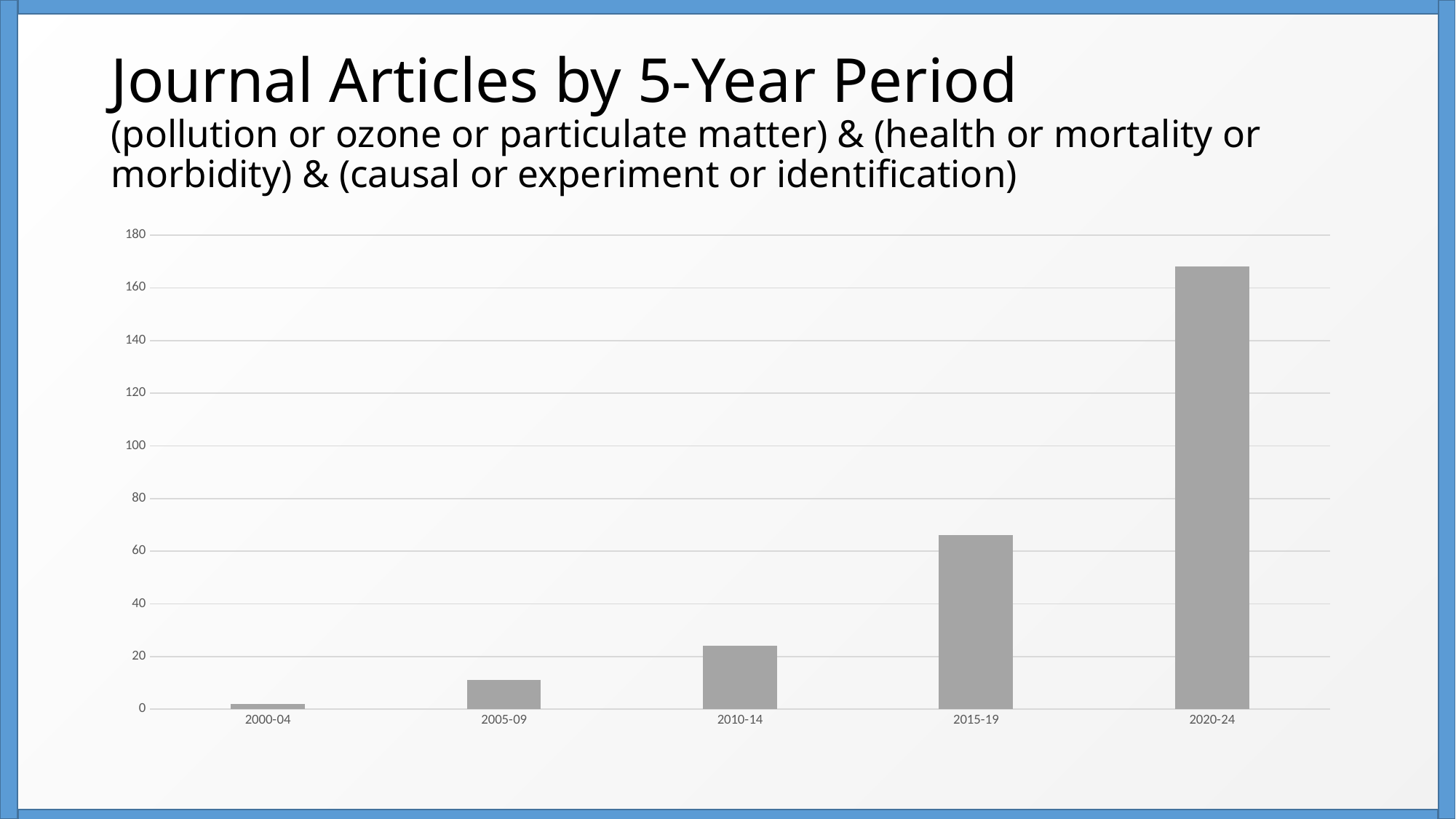
Is the value for 2015-19 greater or less than 60? greater Which is larger, the value for 2015-19 or the value for 2010-14? 2015-19 Is the value for 2020-24 greater or less than 160? greater Is the value for 2005-09 greater or less than 20? less What kind of chart is shown on the slide? bar chart What is the highest value labelled on the vertical axis? 180 How many 5-year periods are shown on the x axis? 5 Which period has the highest number of journal articles? 2020-24 Which period has the lowest number of journal articles? 2000-04 What is the title of the chart on the slide? Journal Articles by 5-Year Period Do the values rise or fall from 2000-04 to 2020-24? rise